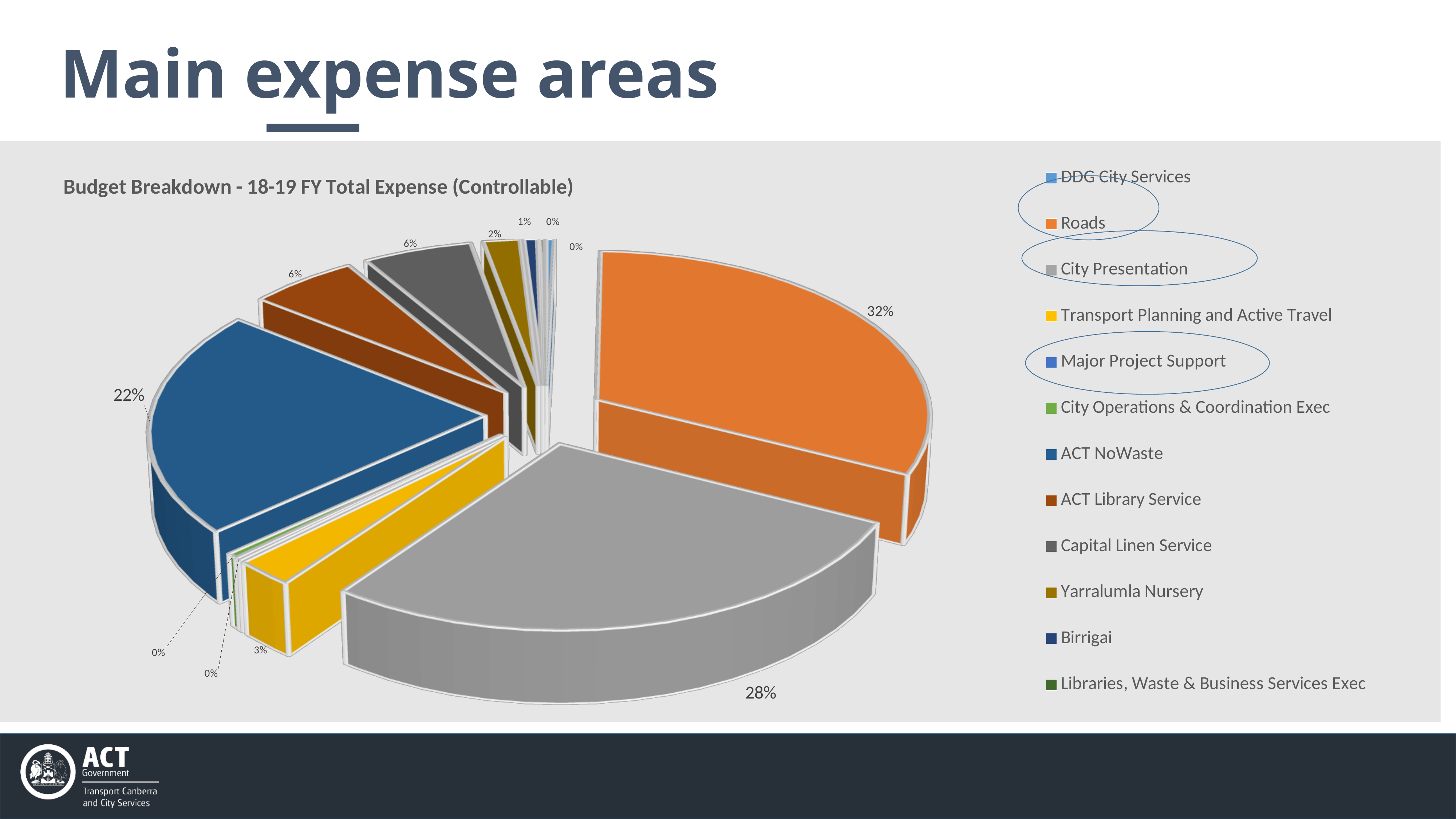
What percentage is shown for Birrigai? 1% What is the title of the chart? Budget Breakdown - 18-19 FY Total Expense (Controllable) Which is larger, the share for Roads or the share for City Presentation? Roads By how many percentage points does Roads exceed City Presentation? 4 percentage points How many categories does the legend list? 12 What type of chart is shown on the slide? Pie chart Which expense area has the largest share of the pie? Roads What share does Yarralumla Nursery have? 2% What share of the total expense is ACT NoWaste? 22% What percentage is shown for City Presentation? 28% What percentage is labelled for Transport Planning and Active Travel? 3% What share of the pie does Roads account for? 32%